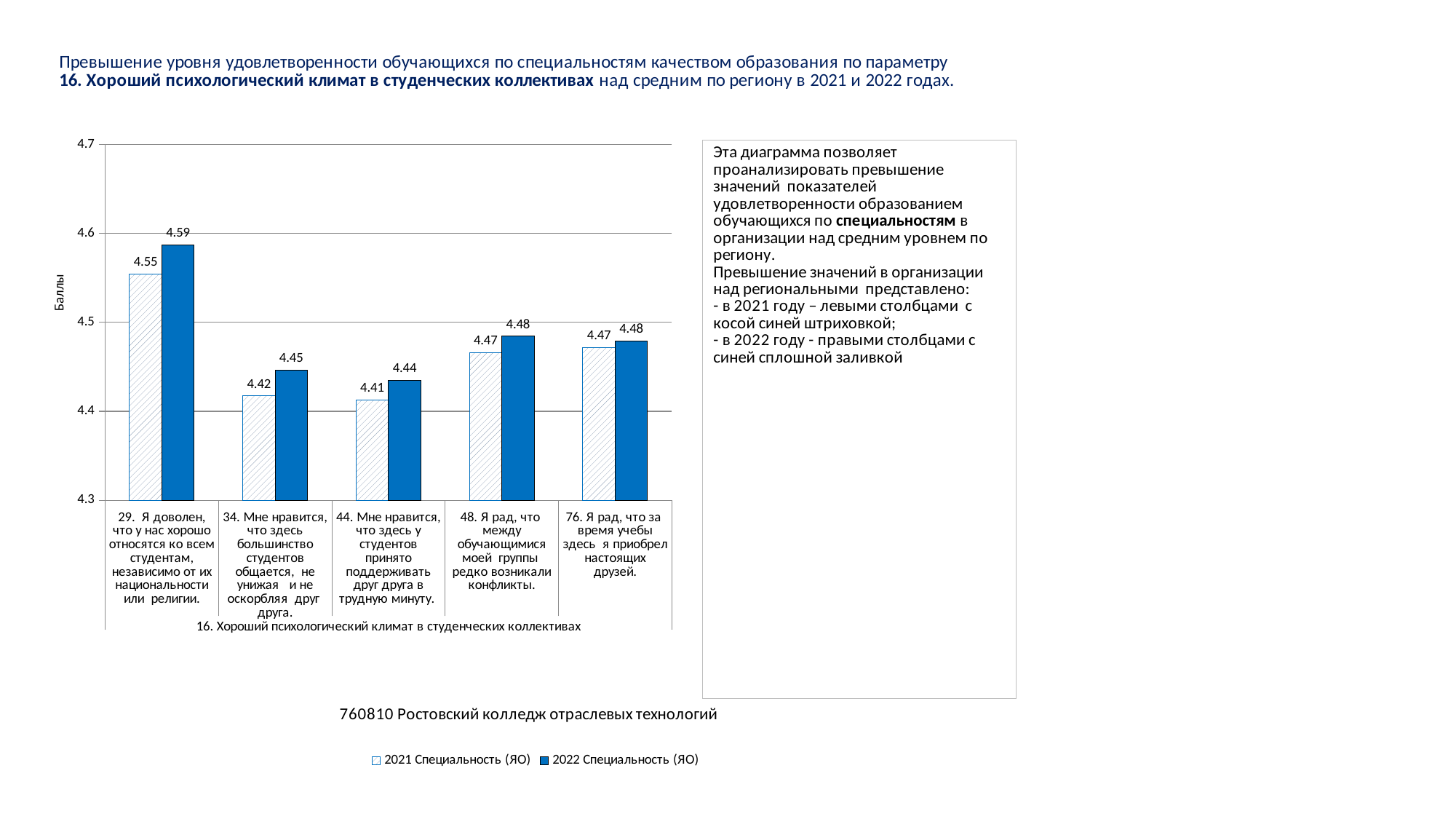
What is the label of the y axis? Баллы Which category has the highest 2022 value? 29. Я доволен, что у нас хорошо относятся ко всем студентам, независимо от их национальности или религии. What is the 2022 value for category 34 ("Мне нравится, что здесь большинство студентов общается...")? 4.45 How many categories are shown on the x axis of the chart? 5 How many series does the legend list? 2 Is the 2021 value for category 48 greater or less than 4.5? less What is the difference between the 2022 and 2021 values for category 29? 0.04 Which category has the lowest 2021 value? 44. Мне нравится, что здесь у студентов принято поддерживать друг друга в трудную минуту. Which is larger for category 34: the 2021 value or the 2022 value? 2022 What type of chart is shown on the slide? bar chart What is the 2022 value for category 44 ("Мне нравится, что здесь у студентов принято поддерживать друг друга...")? 4.44 What is the 2021 value for category 29 ("Я доволен, что у нас хорошо относятся ко всем студентам...")? 4.55